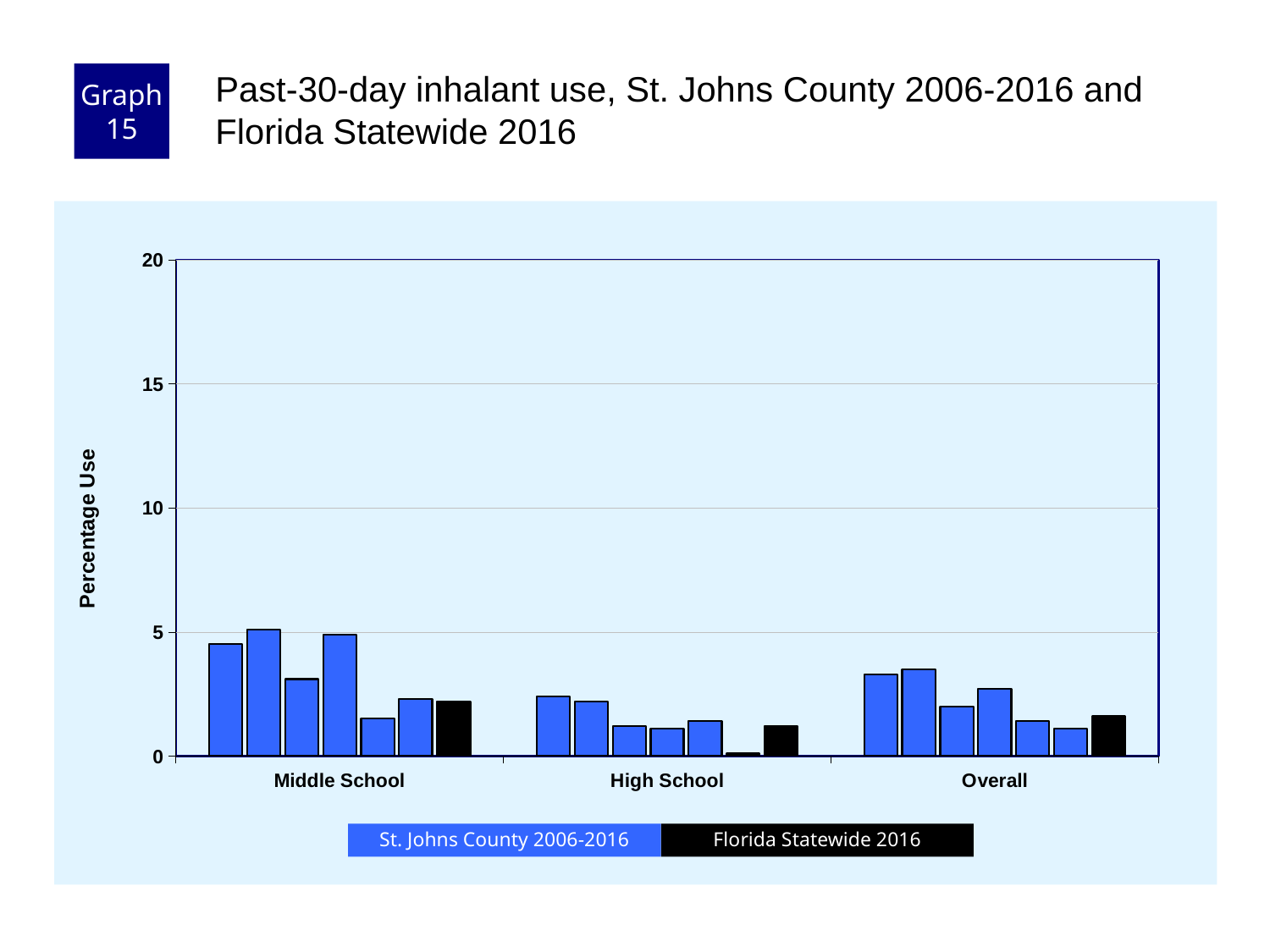
Is the value for Florida Statewide 2016 in the Middle School group greater or less than 5? less Which is larger: the Florida Statewide 2016 value for Middle School or for High School? Middle School Is the value for Florida Statewide 2016 in the Overall group greater or less than 5? less Among the three groups, which has the highest Florida Statewide 2016 value? Middle School Among the three groups, which has the lowest Florida Statewide 2016 value? High School How many category groups are shown along the x axis? 3 Which series is shown in black in the legend? Florida Statewide 2016 What kind of chart is shown on the slide? bar chart How many series does the legend list? 2 What is the label on the y axis? Percentage Use Is the value for Florida Statewide 2016 in the High School group greater or less than 5? less